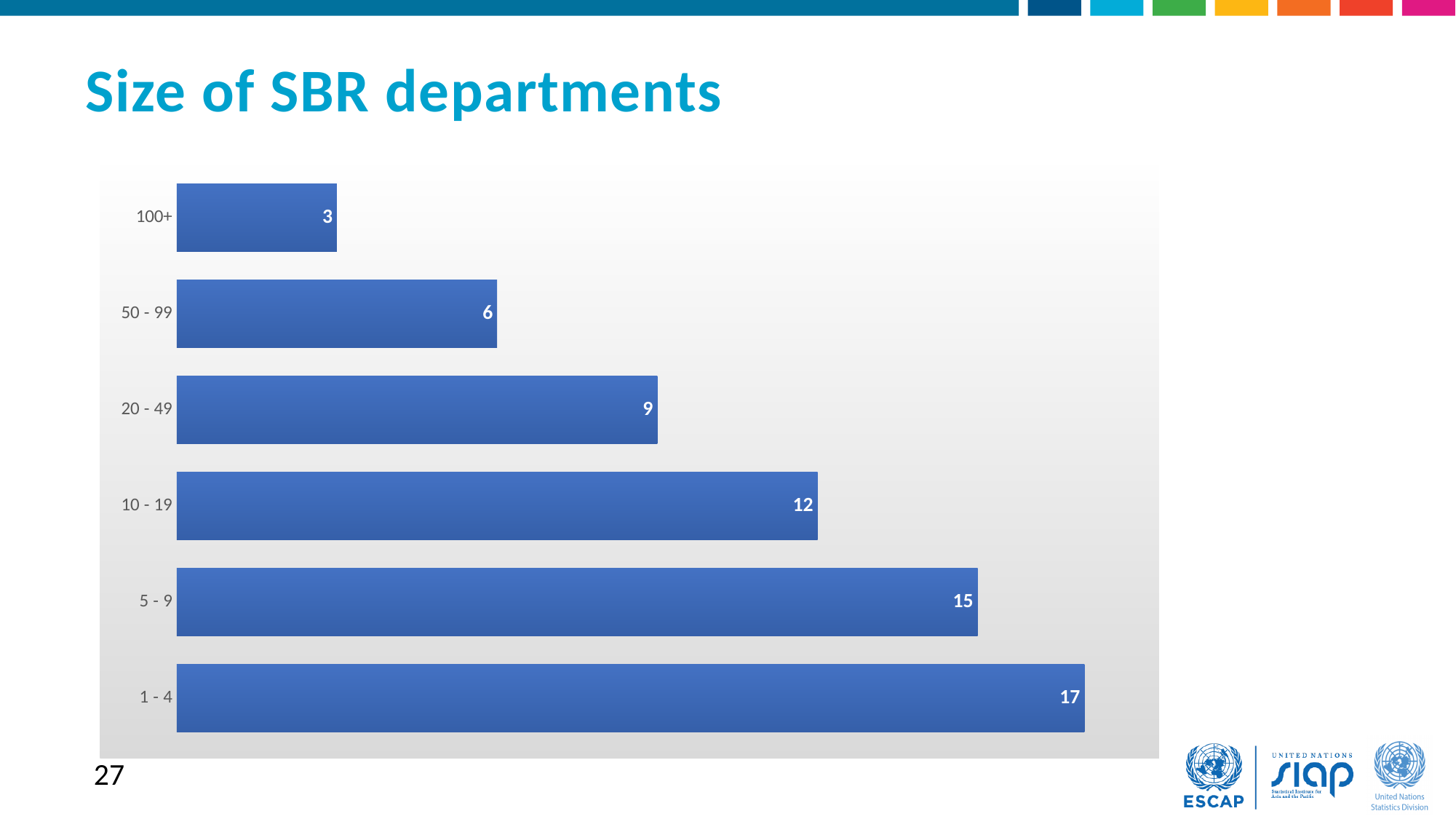
What is the value for the 1 - 4 category? 17 What kind of chart is shown on the slide? bar chart Which is larger, the value for 50 - 99 or the value for 20 - 49? 20 - 49 What is the value for the 20 - 49 category? 9 Which category has the highest value? 1 - 4 What is the difference between the values for 1 - 4 and 100+? 14 What is the title of the slide containing the chart? Size of SBR departments Which category has the lowest value? 100+ How many categories are shown in the chart? 6 What is the value for the 100+ category? 3 What is the total of all the values shown in the chart? 62 What is the difference between the values for 5 - 9 and 10 - 19? 3